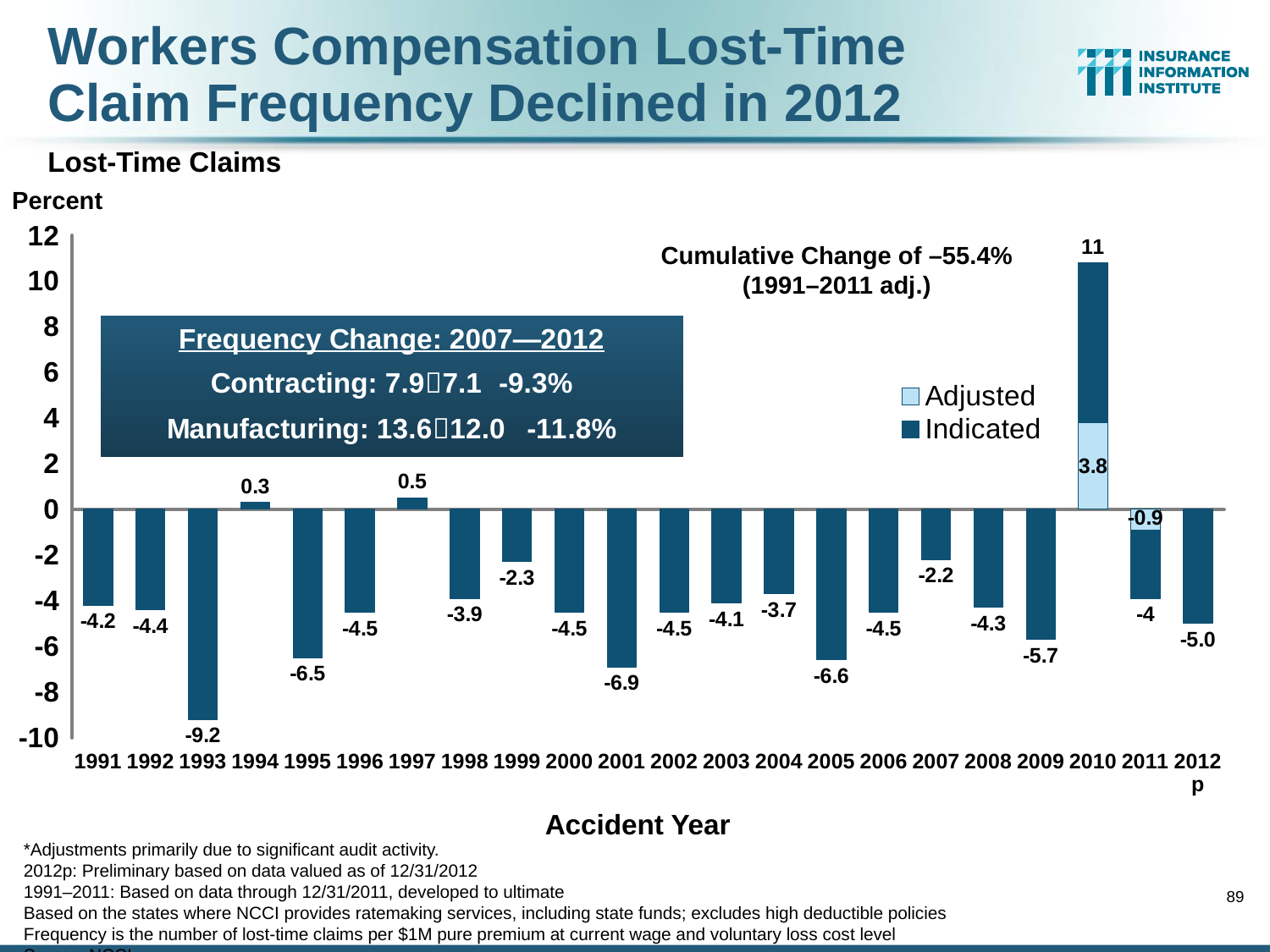
Is the value for 2009 greater or less than -4? less Which is larger, the value for 1994 or the value for 1997? 1997 What is the Indicated value labeled for 2010? 11 What is the difference between the values for 2001 and 2005? 0.3 What kind of chart is shown on the slide? Bar chart How many accident years are shown on the x axis? 22 Which accident year has the lowest value? 1993 Which accident year has the highest value? 2010 What is the value for 2012p? -5.0 What is the Adjusted value shown for 2010? 3.8 How many series does the legend list? 2 What is the value for 1993? -9.2